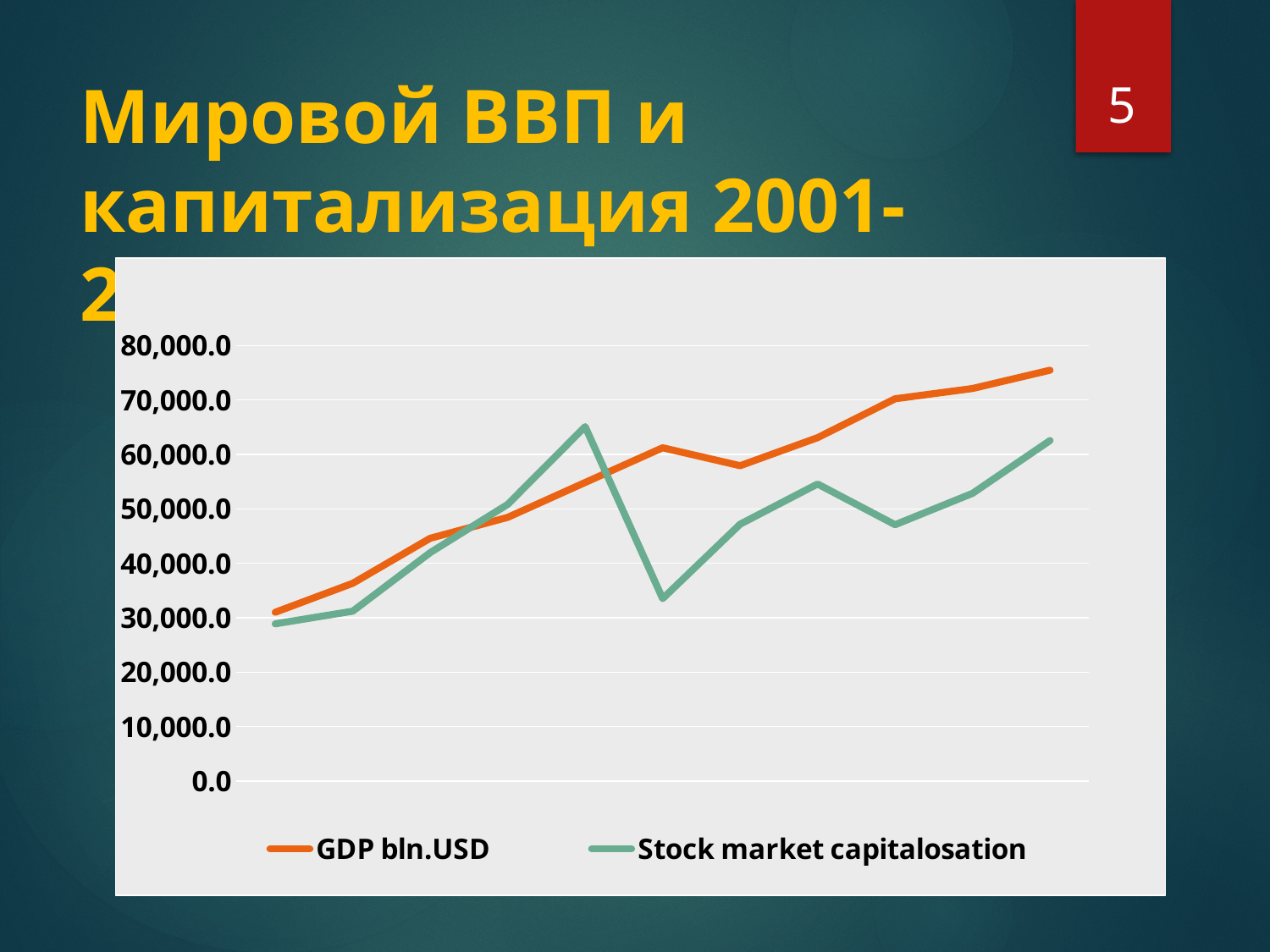
Is the value of GDP bln.USD at the rightmost point greater or less than 70,000.0? greater Is the highest value reached by the Stock market capitalosation line greater or less than 60,000.0? greater At the rightmost point, which series has the higher value? GDP bln.USD Which series reaches the higher maximum value on the chart? GDP bln.USD What kind of chart is shown on the slide? line chart What colour is the GDP bln.USD line? orange What are the two series named in the legend? GDP bln.USD and Stock market capitalosation Is the lowest value of the Stock market capitalosation line greater or less than 40,000.0? less Does the GDP bln.USD line generally rise or fall from left to right? rise How many series does the legend list? 2 How many data points does each line have? 11